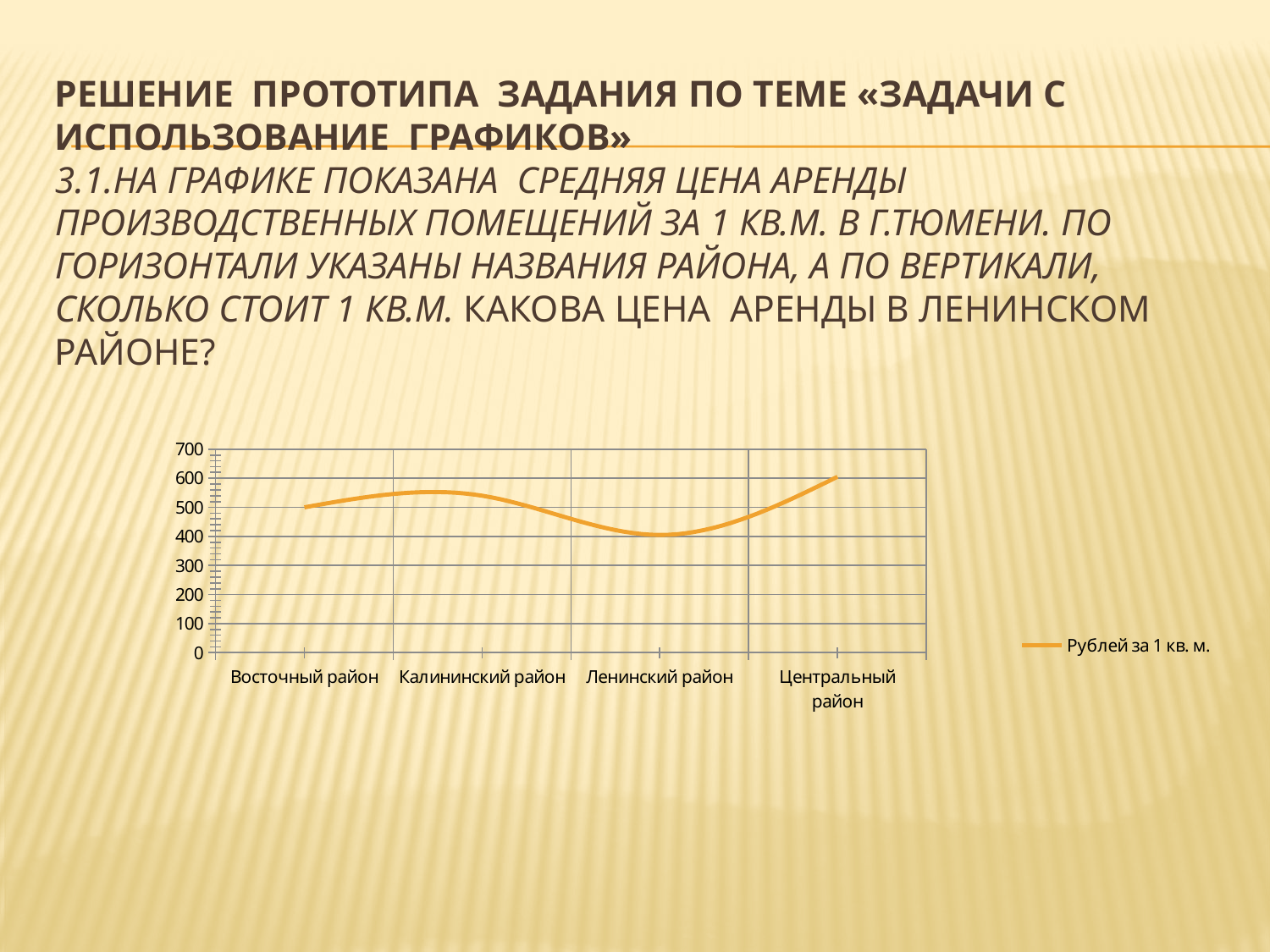
What kind of chart is shown on the slide? line chart Which district has the lowest value? Ленинский район How many series does the chart legend list? 1 Is the value for Калининский район greater or less than 500? greater Which is larger, the value for Восточный район or the value for Ленинский район? Восточный район Which district has the highest value? Центральный район What is the name of the series in the chart legend? Рублей за 1 кв. м. What is the value for Восточный район? 500 How many districts are shown on the x axis of the chart? 4